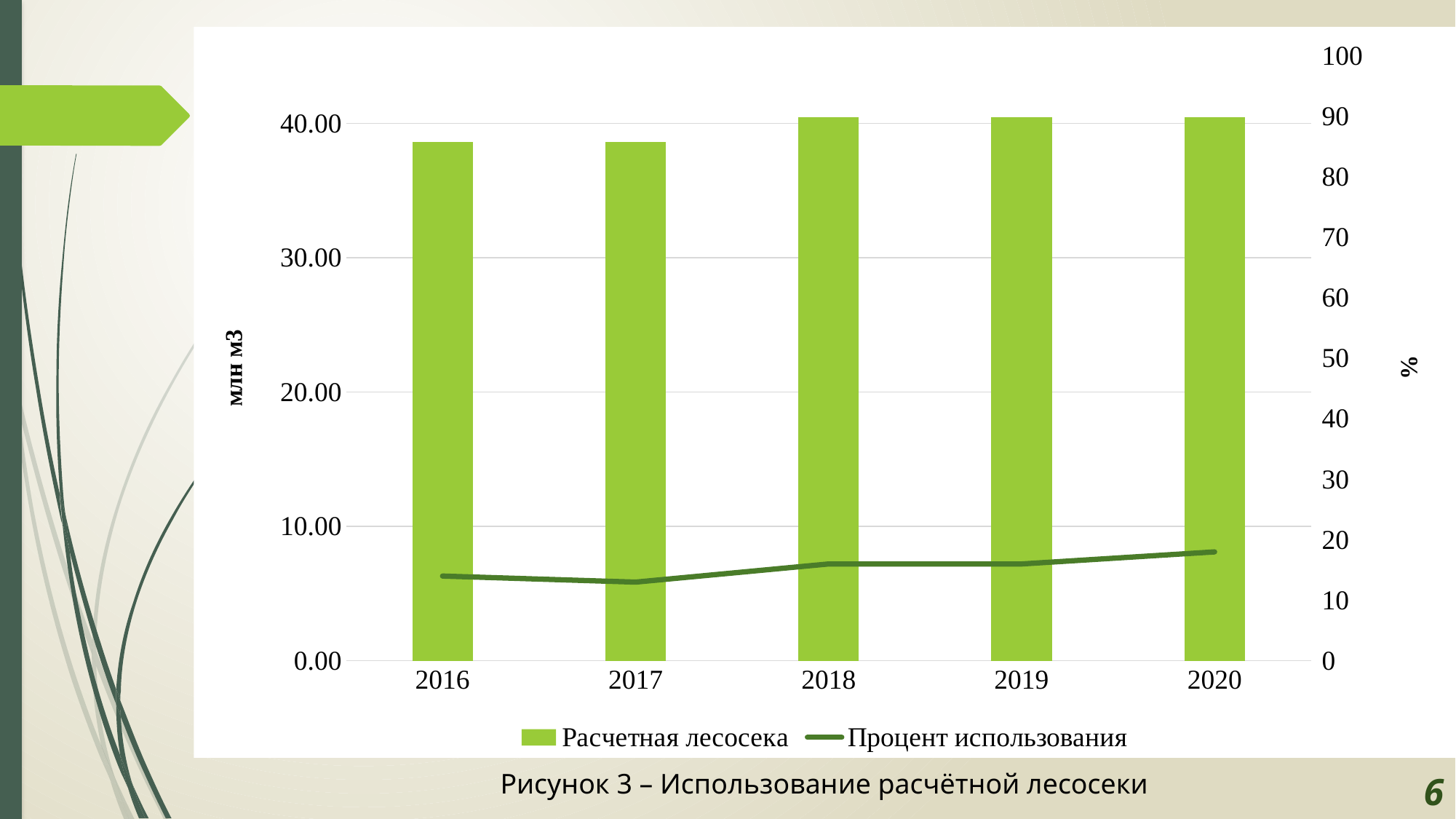
Is the value of the Расчетная лесосека bar for 2016 greater or less than 40? less Is the Процент использования value for 2020 greater or less than 20 on the right axis? less What kind of chart is shown on the slide? Combined bar and line chart Is the value of the Расчетная лесосека bar for 2019 greater or less than 30? greater In which year is the Процент использования line at its highest? 2020 How many series does the chart legend list? 2 How many years are shown on the x axis of the chart? 5 Which is larger, the Расчетная лесосека bar for 2016 or for 2018? 2018 Does the Процент использования line overall rise or fall from 2016 to 2020? rise Which is larger, the Процент использования value for 2017 or for 2020? 2020 What is the label of the left vertical axis of the chart? млн м3